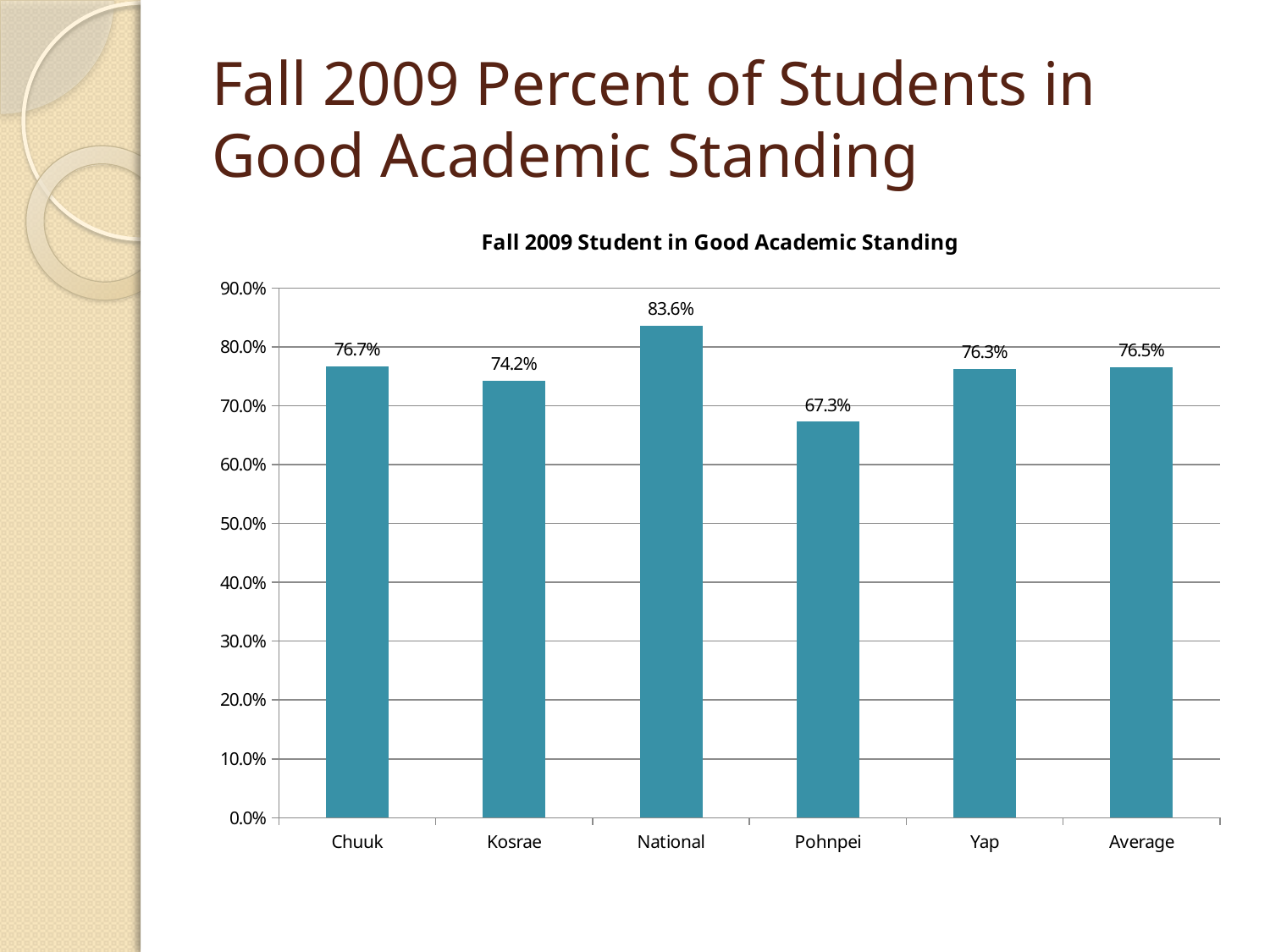
Which category has the lowest value? Pohnpei What kind of chart is this? Bar chart What is the difference between the values for Chuuk and Kosrae? 2.5% Which category has the highest value? National What is the title of the chart? Fall 2009 Student in Good Academic Standing What is the difference between the values for National and Pohnpei? 16.3% What is the value for National? 83.6% What is the value for Pohnpei? 67.3% What is the value for Kosrae? 74.2% Which is larger, the value for Kosrae or the value for Yap? Yap What is the value for Average? 76.5% How many categories are shown on the x axis? 6